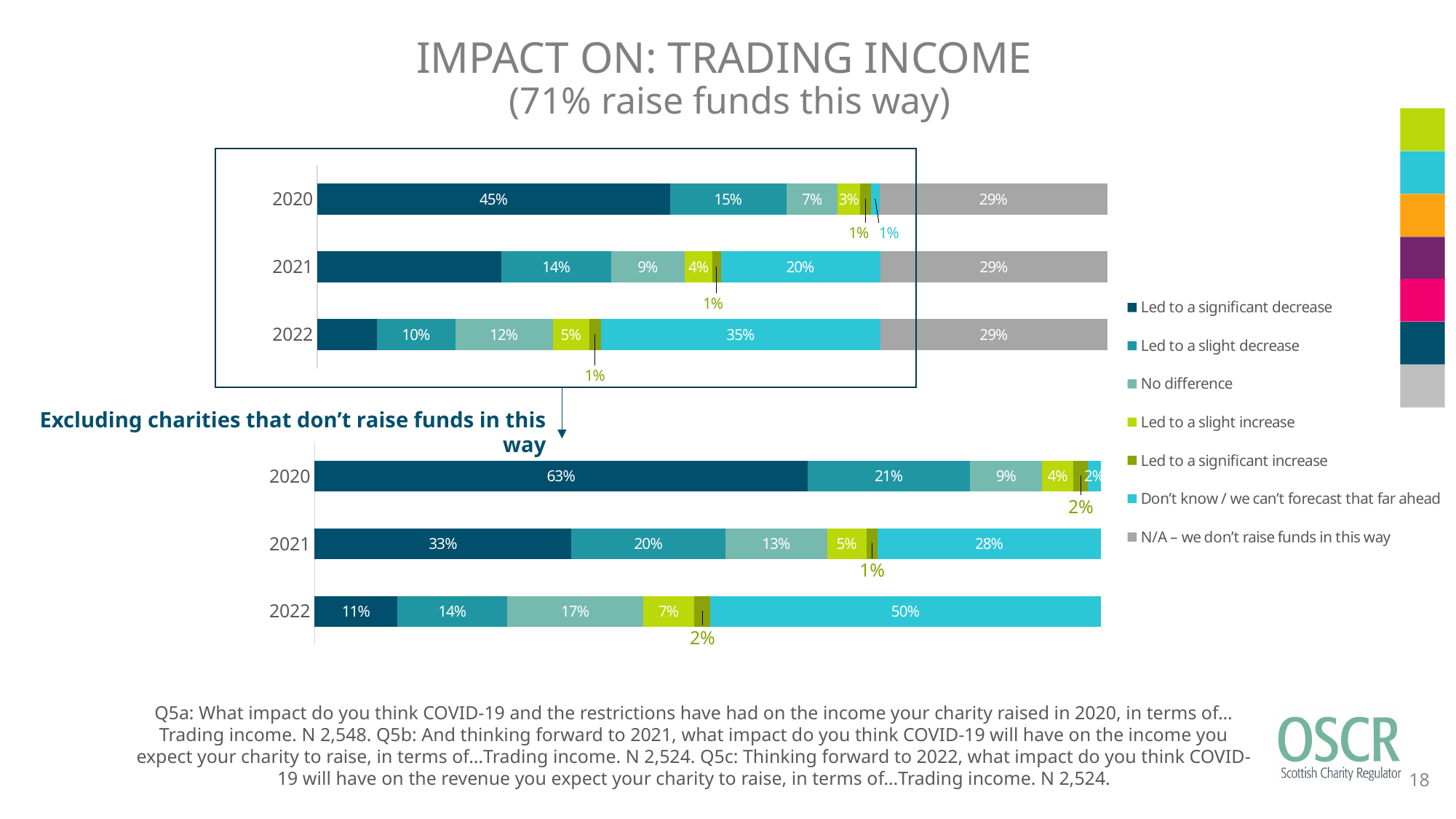
In the top chart, what percentage of charities said COVID-19 led to a significant decrease in trading income in 2020? 45% In the top chart, what is the value for 'Don't know / we can't forecast that far ahead' in 2022? 35% In the top chart, what is the value for 'N/A – we don't raise funds in this way' in 2021? 29% In the bottom chart, what is the value for 'Don't know / we can't forecast that far ahead' in 2022? 50% In the bottom chart, which year has the lowest value for 'Led to a slight increase'? 2020 In the bottom chart, which year has the highest value for 'Led to a significant decrease'? 2020 How many series does the legend list? 7 In the bottom chart (excluding charities that don't raise funds this way), what is the value for 'Led to a significant decrease' in 2020? 63% In the top chart, which is larger: 'Led to a slight decrease' in 2020 or 'Led to a slight decrease' in 2022? 2020 In the bottom chart, what is the value for 'No difference' in 2021? 13% In the bottom chart, what is the difference between the 'Led to a significant decrease' values for 2020 and 2021? 30% In the bottom chart, does the value for 'Don't know / we can't forecast that far ahead' rise or fall from 2020 to 2022? rise